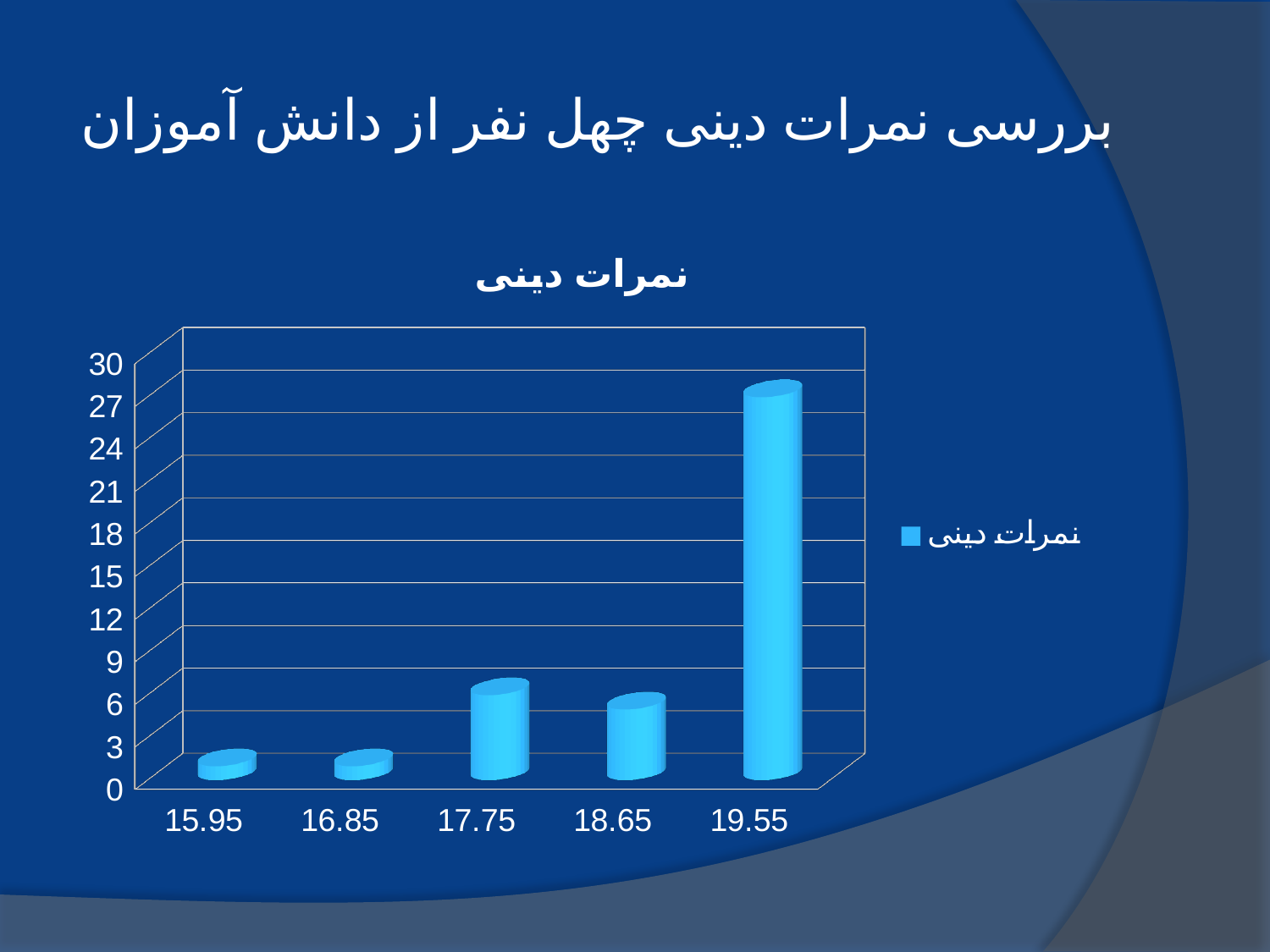
How many series does the chart legend list? 1 Which has the larger value, 17.75 or 15.95? 17.75 Which category has the highest bar in the chart? 19.55 What kind of chart is shown on the slide? bar chart Which has the larger value, 19.55 or 17.75? 19.55 Is the value for 16.85 greater or less than 9? less Is the value for 19.55 greater or less than 21? greater How many categories are shown on the x axis of the chart? 5 Is the value for 18.65 greater or less than 9? less What is the title of the chart? نمرات دینی